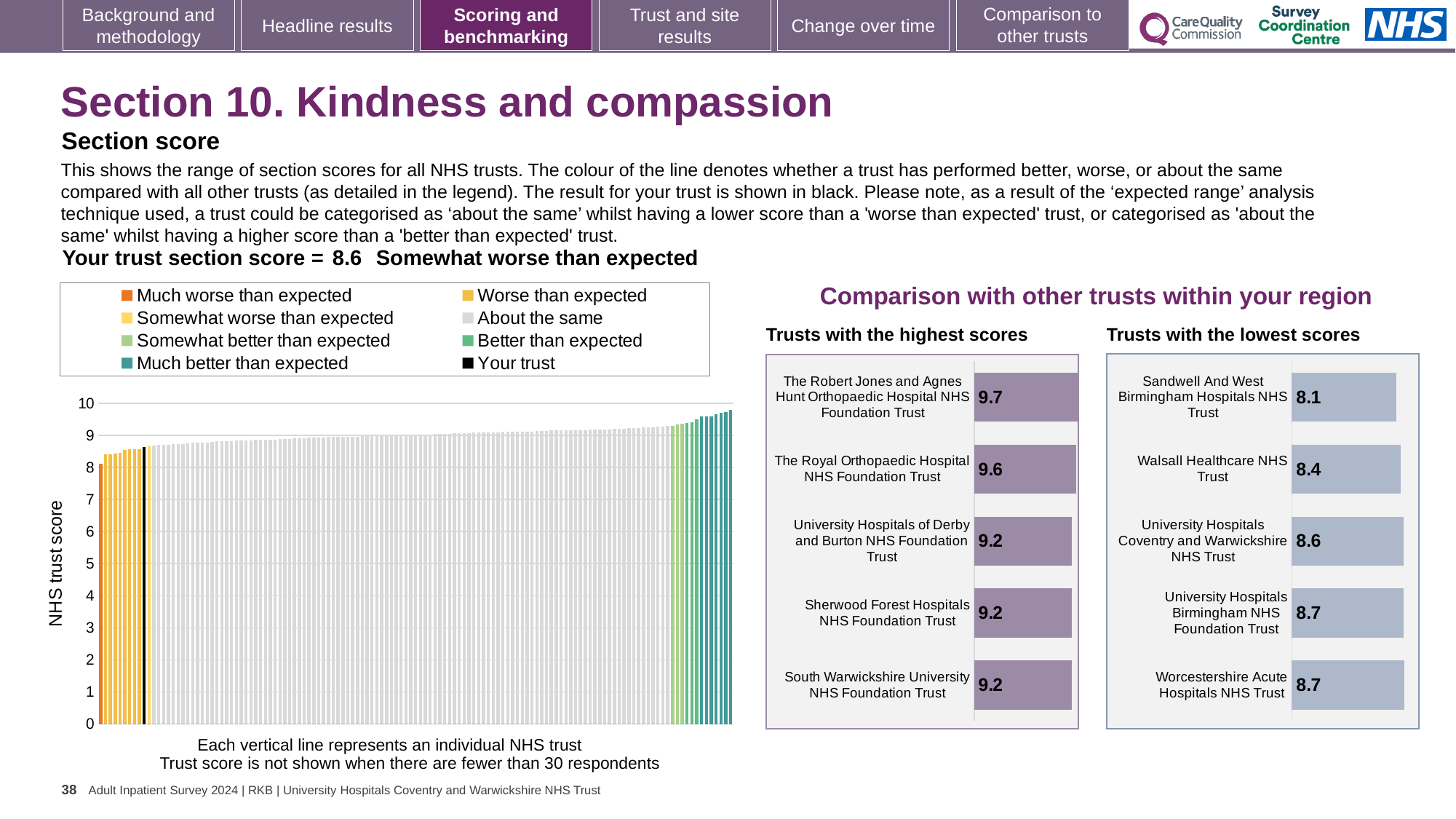
In the 'Trusts with the lowest scores' chart, which trust has the lowest score? Sandwell And West Birmingham Hospitals NHS Trust In the 'Trusts with the lowest scores' chart, which has the larger score: Walsall Healthcare NHS Trust or University Hospitals Birmingham NHS Foundation Trust? University Hospitals Birmingham NHS Foundation Trust In the main chart of NHS trust scores on the left, what is the section score for your trust? 8.6 In the 'Trusts with the lowest scores' chart, what is the score for Sandwell And West Birmingham Hospitals NHS Trust? 8.1 How many entries does the legend of the main chart on the left list? 8 In the 'Trusts with the highest scores' chart, which trust has the highest score? The Robert Jones and Agnes Hunt Orthopaedic Hospital NHS Foundation Trust In the 'Trusts with the highest scores' chart, what is the difference between the scores of The Robert Jones and Agnes Hunt Orthopaedic Hospital NHS Foundation Trust and The Royal Orthopaedic Hospital NHS Foundation Trust? 0.1 In the 'Trusts with the lowest scores' chart, what is the score for Walsall Healthcare NHS Trust? 8.4 How many trusts are shown in the 'Trusts with the highest scores' chart? 5 In the 'Trusts with the highest scores' chart, what is the score for The Robert Jones and Agnes Hunt Orthopaedic Hospital NHS Foundation Trust? 9.7 What kind of chart is the main chart of NHS trust scores on the left? Bar chart In the 'Trusts with the lowest scores' chart, what is the difference between the scores of Worcestershire Acute Hospitals NHS Trust and Sandwell And West Birmingham Hospitals NHS Trust? 0.6